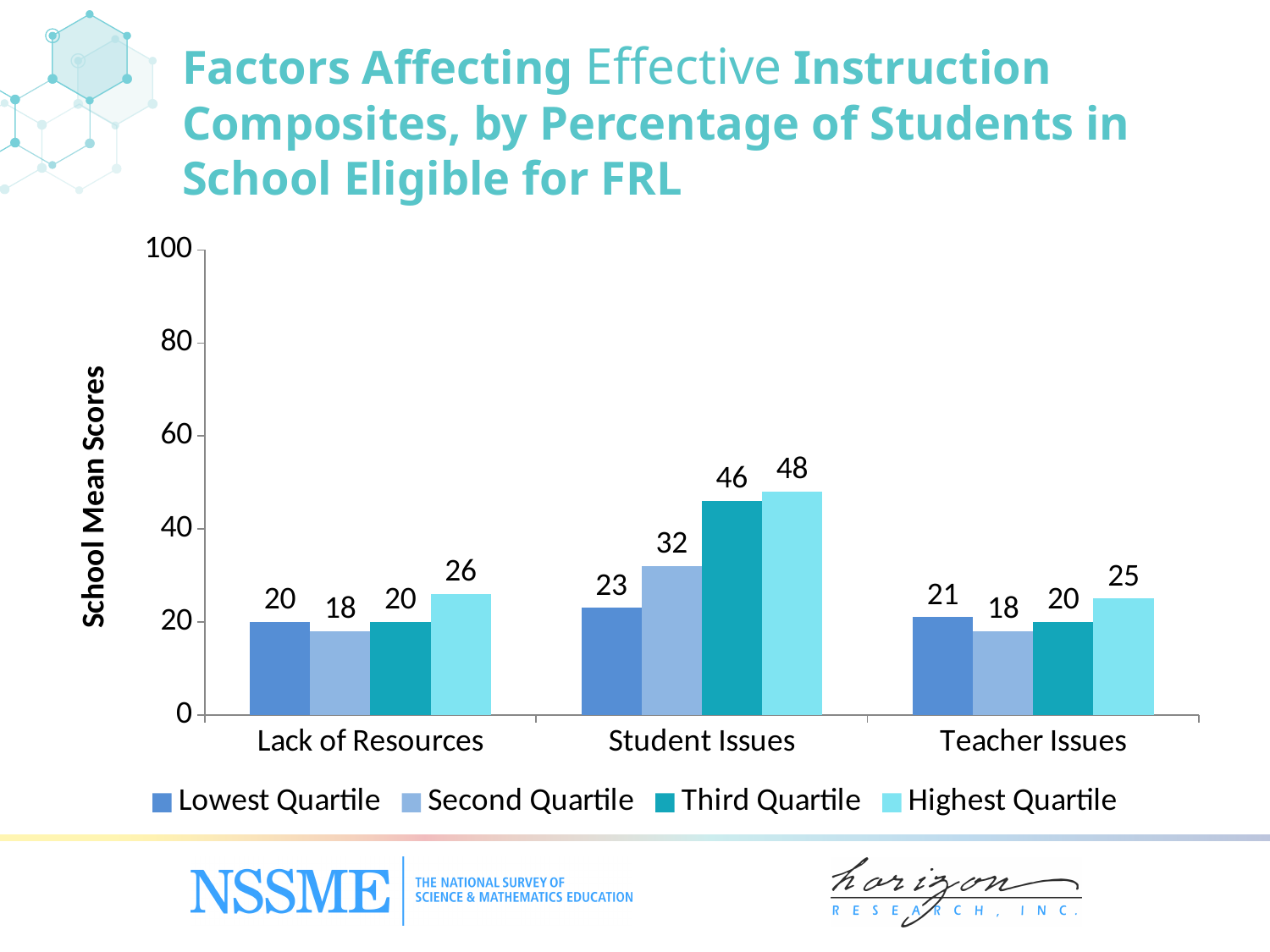
Which is larger: the Second Quartile score for Student Issues or the Highest Quartile score for Teacher Issues? Second Quartile score for Student Issues Is the Third Quartile value for Student Issues greater or less than 40? greater What is the difference between the Highest Quartile and Lowest Quartile scores for Student Issues? 25 What is the school mean score for Teacher Issues in the Lowest Quartile? 21 What kind of chart is shown on the slide? Bar chart How many series does the legend list? 4 Which category has the highest school mean score for the Third Quartile? Student Issues What is the school mean score for Student Issues in the Highest Quartile? 48 What is the label of the y axis? School Mean Scores What is the school mean score for Lack of Resources in the Second Quartile? 18 Which quartile has the lowest school mean score for Student Issues? Lowest Quartile How many categories are shown on the x axis? 3